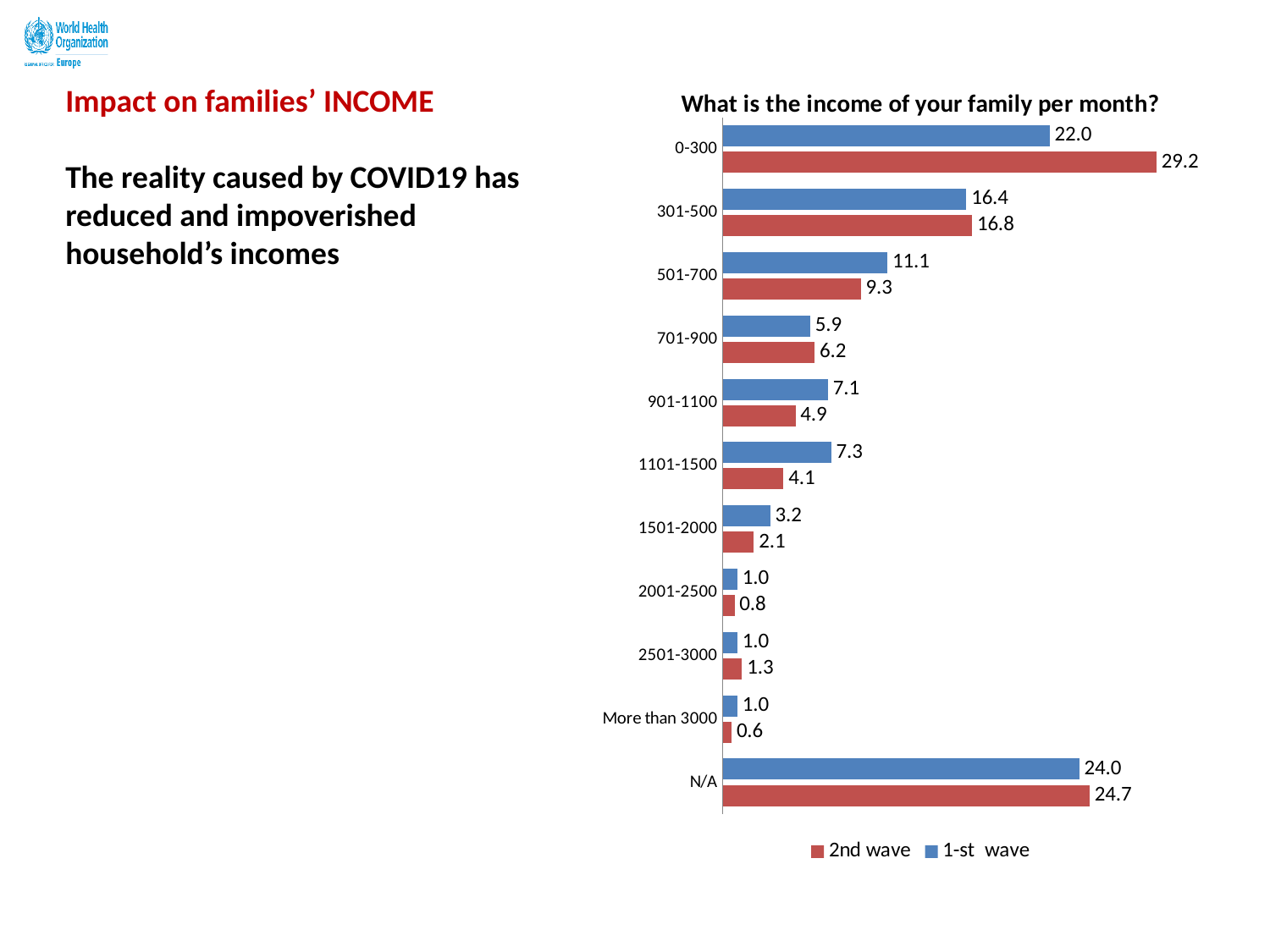
What is the 2nd wave value for the 0-300 income category? 29.2 What is the 1-st wave value for the 501-700 income category? 11.1 How many series does the legend list? 2 For the 1101-1500 category, which is larger: the 1-st wave value or the 2nd wave value? 1-st wave What type of chart is shown on the slide? Bar chart Which income category has the lowest 2nd wave value? More than 3000 Which income category has the highest 1-st wave value? N/A What is the 2nd wave value for the N/A category? 24.7 What is the difference between the 2nd wave and 1-st wave values for the 0-300 category? 7.2 What is the difference between the 1-st wave and 2nd wave values for the 501-700 category? 1.8 Which income category has the highest 2nd wave value? 0-300 How many income categories are shown on the chart? 11